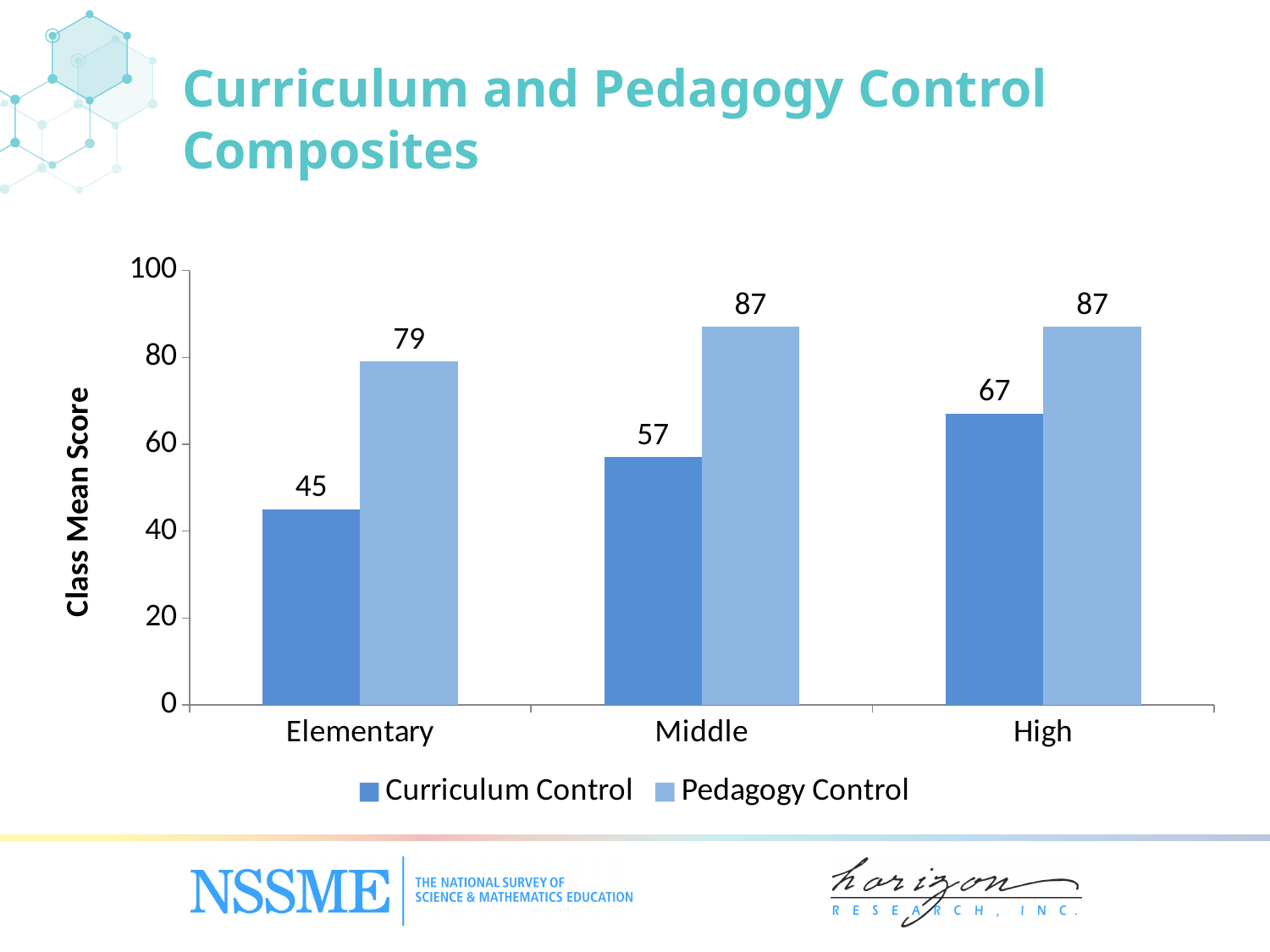
What is the difference between the Curriculum Control values for High and Middle? 10 Which grade level has the lowest Curriculum Control value? Elementary What kind of chart is shown on the slide? Bar chart How many series does the legend list? 2 What is the Curriculum Control value for Elementary? 45 Do the Curriculum Control values rise or fall from Elementary to High? Rise Which grade level has the highest Curriculum Control value? High What is the difference between the Pedagogy Control and Curriculum Control values for Elementary? 34 How many grade levels are shown on the x axis? 3 What is the Curriculum Control value for High? 67 Which is larger for Middle: Curriculum Control or Pedagogy Control? Pedagogy Control What is the Pedagogy Control value for Middle? 87